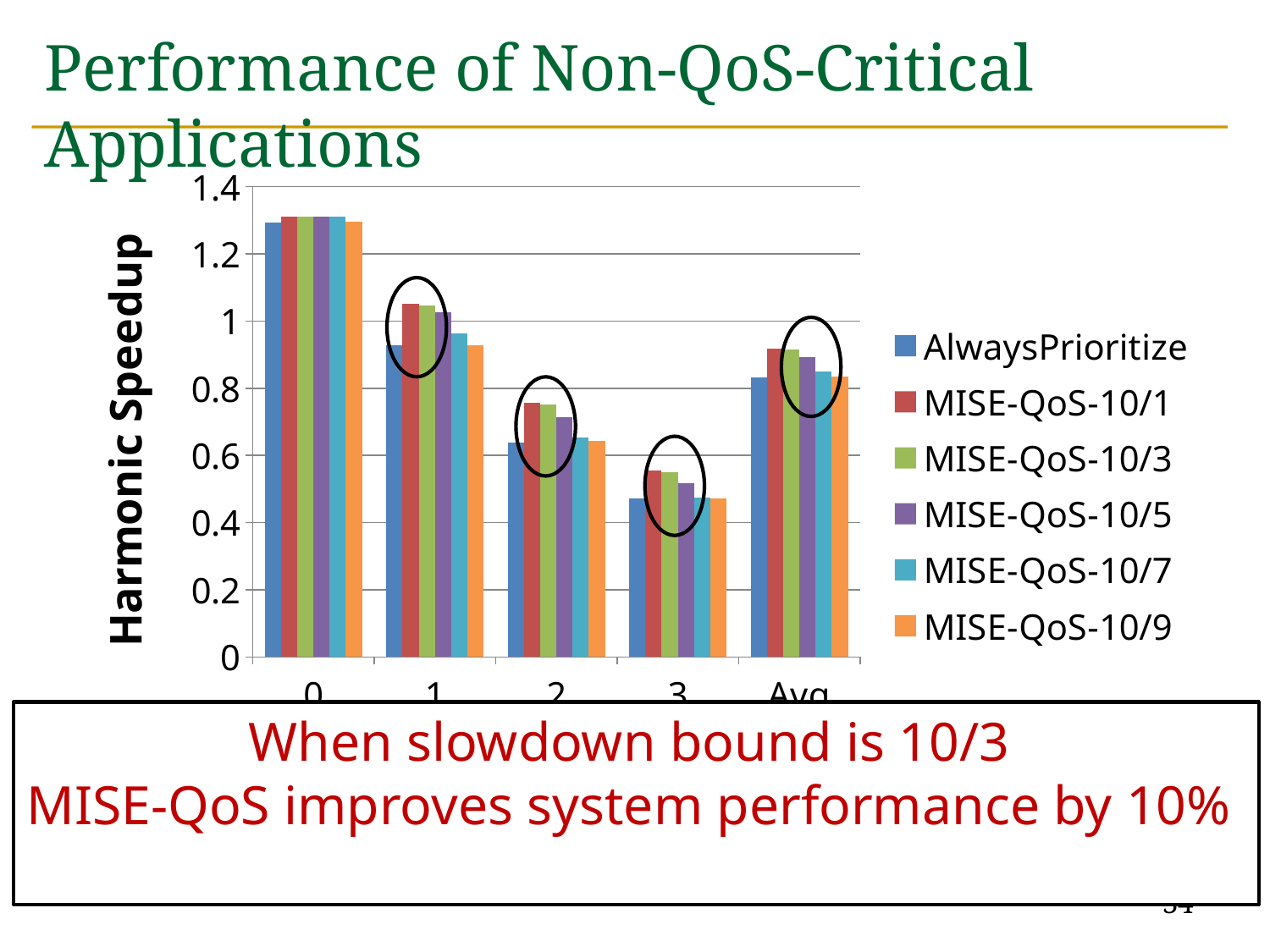
For category 3, which is larger: MISE-QoS-10/1 or MISE-QoS-10/9? MISE-QoS-10/1 How many categories are shown along the x axis? 5 What is the title of the y axis? Harmonic Speedup Is the MISE-QoS-10/9 value for Avg greater or less than 1? less Which category has the highest AlwaysPrioritize value? 0 Is the AlwaysPrioritize value for category 3 greater or less than 0.6? less Do the AlwaysPrioritize values rise or fall from category 0 to category 3? fall Is the AlwaysPrioritize value for category 0 greater or less than 1.2? greater What kind of chart is shown on the slide? bar chart How many series does the legend list? 6 For category 1, which is larger: AlwaysPrioritize or MISE-QoS-10/1? MISE-QoS-10/1